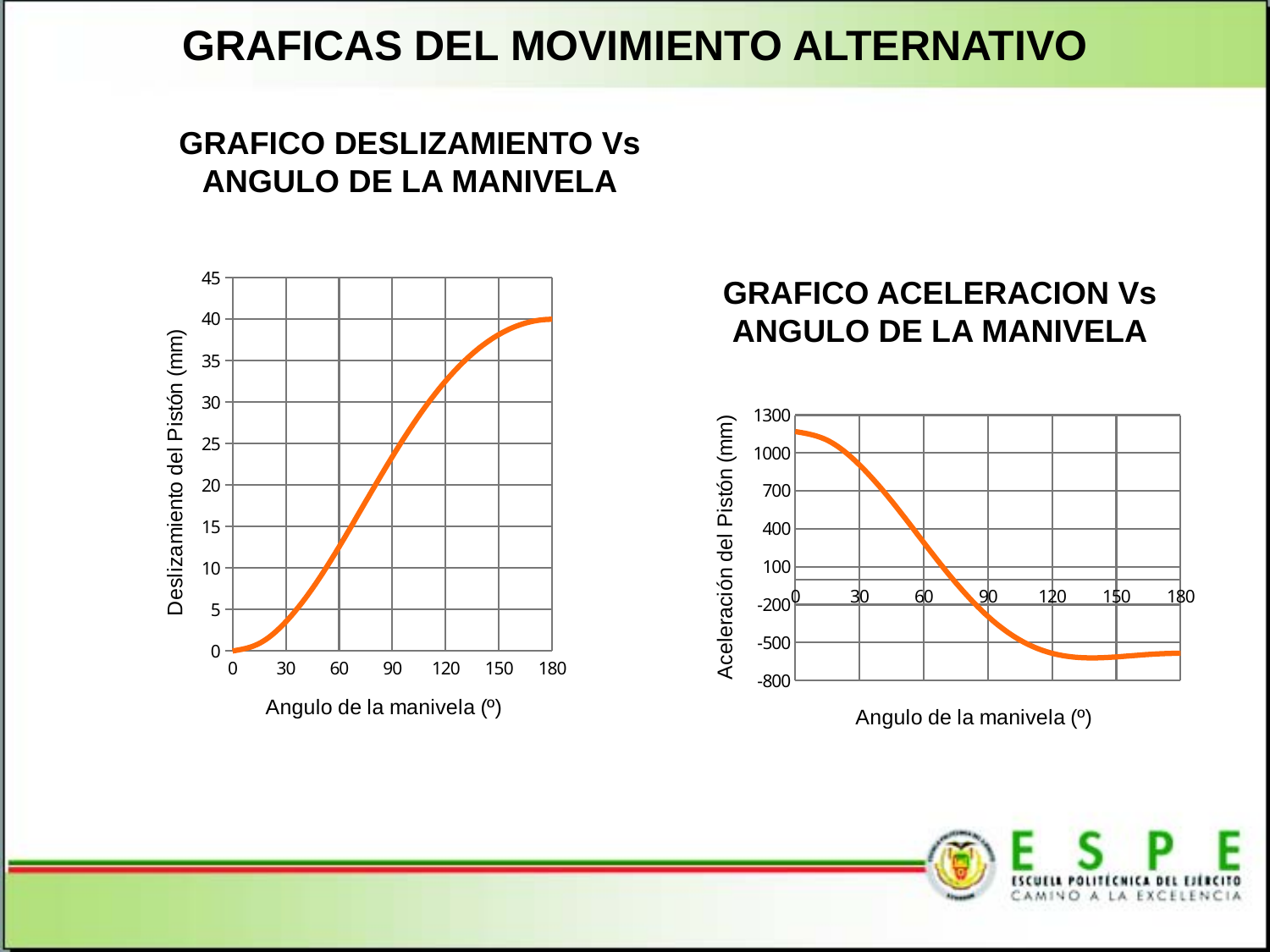
In the GRAFICO DESLIZAMIENTO Vs ANGULO DE LA MANIVELA chart, what is the value of Deslizamiento del Pistón at an angle of 0? 0 What is the x-axis label of the GRAFICO ACELERACION Vs ANGULO DE LA MANIVELA chart? Angulo de la manivela (º) In the GRAFICO DESLIZAMIENTO Vs ANGULO DE LA MANIVELA chart, is the value at an angle of 90 greater or less than 20? greater In the GRAFICO ACELERACION Vs ANGULO DE LA MANIVELA chart, is the value at an angle of 120 greater or less than -200? less In the GRAFICO ACELERACION Vs ANGULO DE LA MANIVELA chart, do the values rise or fall as the angle increases from 0 to 120? fall What kind of chart is the GRAFICO ACELERACION Vs ANGULO DE LA MANIVELA chart? line chart In the GRAFICO DESLIZAMIENTO Vs ANGULO DE LA MANIVELA chart, do the values rise or fall as the angle increases from 0 to 180? rise What kind of chart is the GRAFICO DESLIZAMIENTO Vs ANGULO DE LA MANIVELA chart? line chart In the GRAFICO DESLIZAMIENTO Vs ANGULO DE LA MANIVELA chart, what is the value of Deslizamiento del Pistón at an angle of 180? 40 In the GRAFICO DESLIZAMIENTO Vs ANGULO DE LA MANIVELA chart, is the value at an angle of 30 greater or less than 5? less What is the y-axis label of the GRAFICO DESLIZAMIENTO Vs ANGULO DE LA MANIVELA chart? Deslizamiento del Pistón (mm)